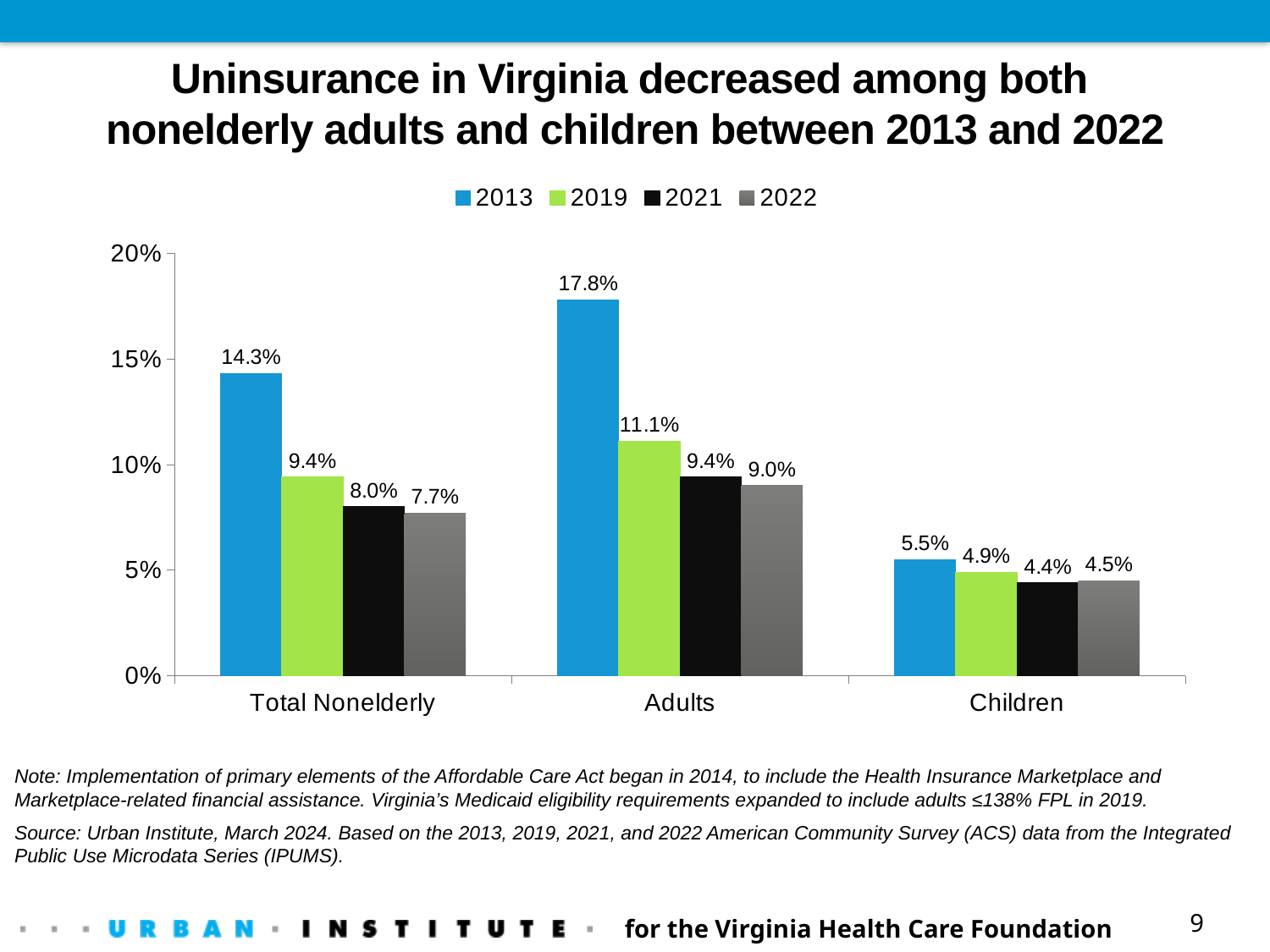
What is the difference between the 2013 and 2022 uninsurance rates for Total Nonelderly? 6.6 percentage points What was the uninsurance rate for Adults in 2013? 17.8% What kind of chart is shown on the slide? Bar chart Which category had the lowest uninsurance rate in 2021? Children Which is larger: the 2021 uninsurance rate for Adults or the 2021 rate for Total Nonelderly? Adults What is the difference between the 2013 and 2019 uninsurance rates for Adults? 6.7 percentage points Which year does the legend show in blue? 2013 What was the uninsurance rate for Total Nonelderly in 2019? 9.4% How many series does the legend list? 4 Which category had the highest uninsurance rate in 2013? Adults How many categories are shown on the x axis? 3 What was the uninsurance rate for Children in 2022? 4.5%